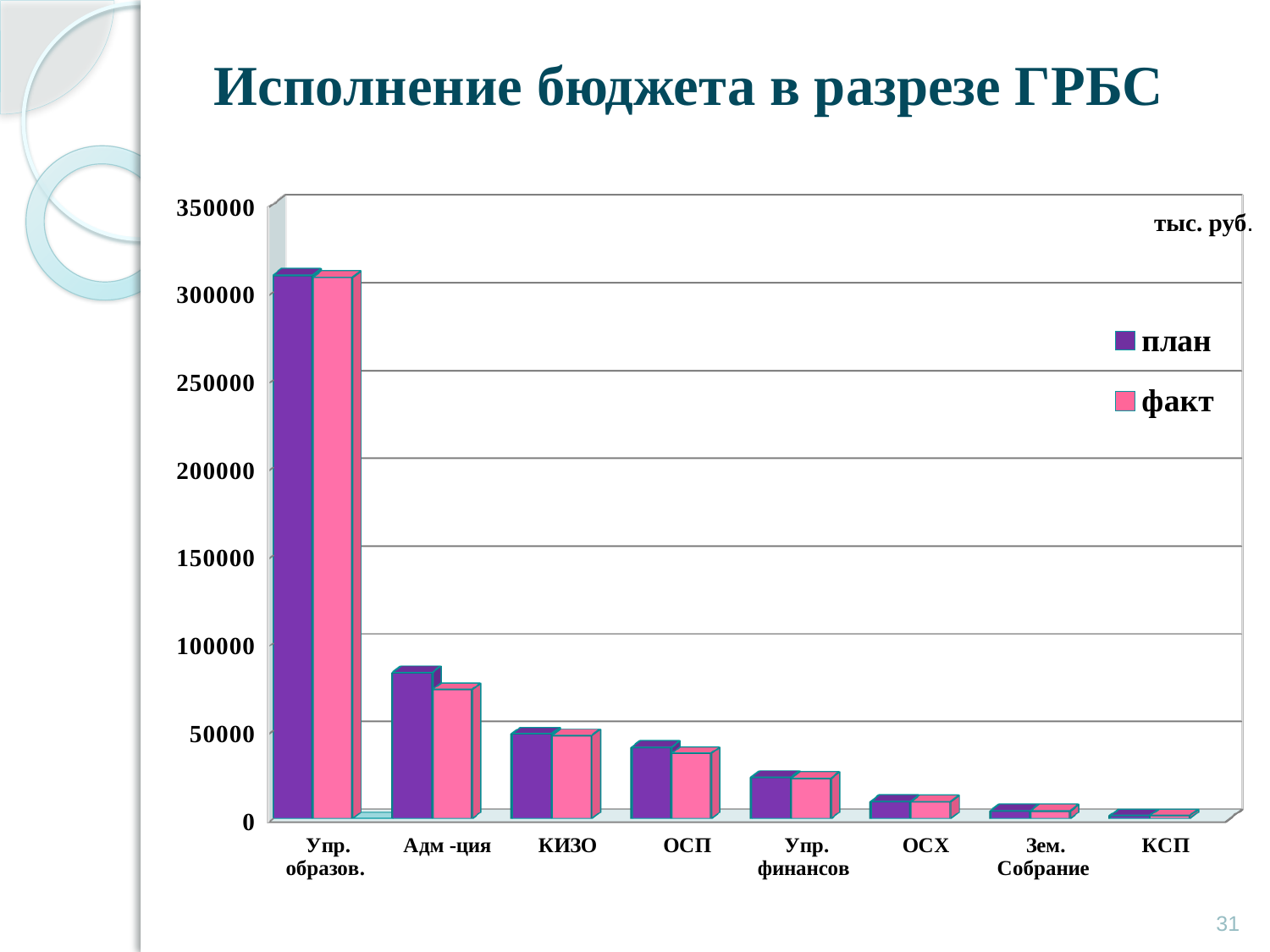
Is the план value for Адм -ция greater or less than 100000? less What kind of chart is shown on the slide? bar chart What unit is indicated in the top right corner of the chart? тыс. руб. Do the план values rise or fall moving from left to right along the x axis? fall Which category has the highest план value? Упр. образов. Is the план value for ОСП greater or less than 50000? less How many series does the legend list? 2 Is the факт value for Адм -ция greater or less than 50000? greater How many categories are shown on the x axis? 8 Which category has the lowest факт value? КСП For Адм -ция, which is larger: план or факт? план